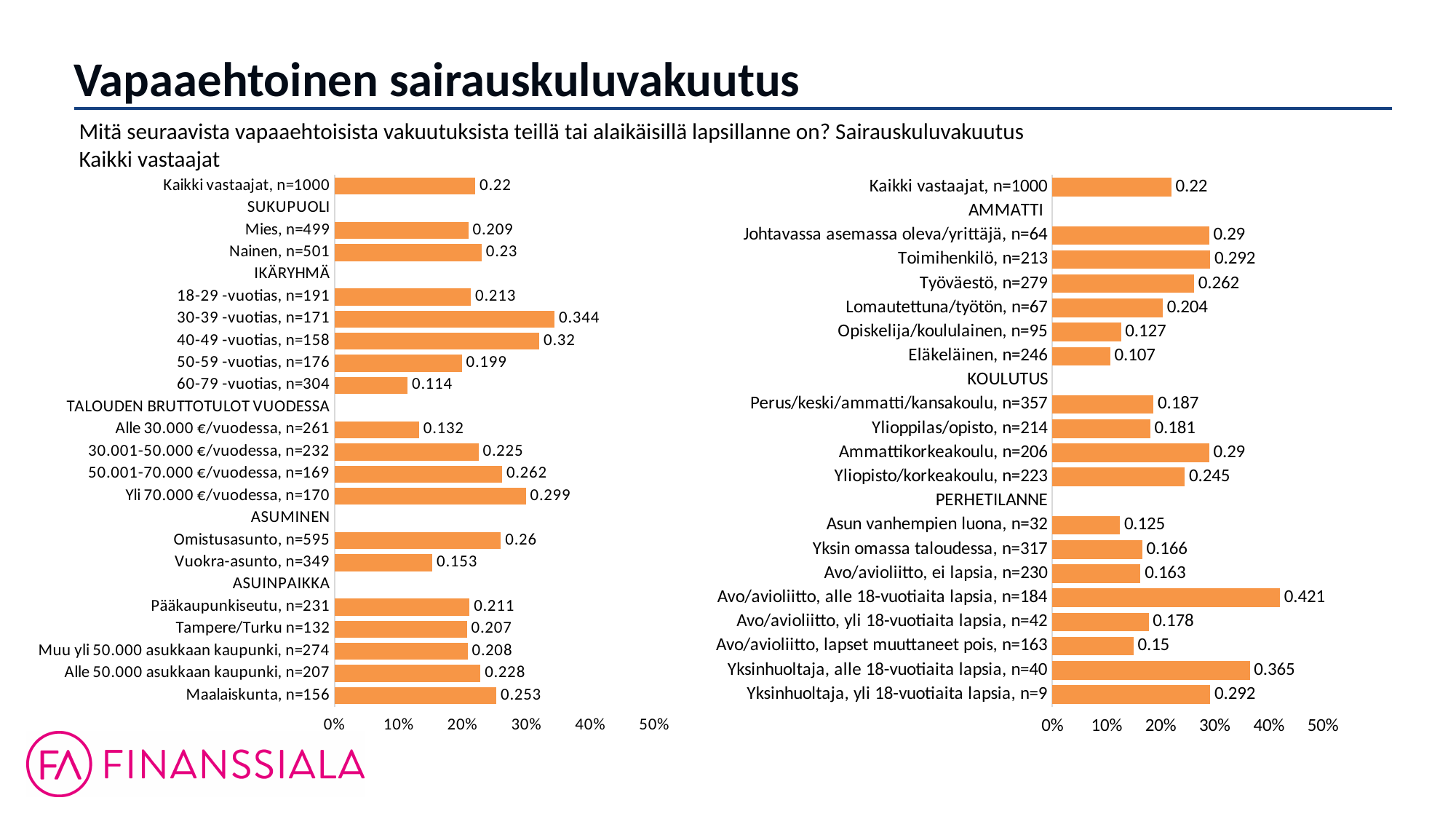
In the left chart, which is larger: the value for Omistusasunto, n=595 or Maalaiskunta, n=156? Omistusasunto, n=595 In the right chart, what is the value for Yksinhuoltaja, alle 18-vuotiaita lapsia, n=40? 0.365 In the right chart, which category has the highest value? Avo/avioliitto, alle 18-vuotiaita lapsia, n=184 In the left chart, what is the value for Vuokra-asunto, n=349? 0.153 In the left chart, what is the difference between the values for Yli 70.000 €/vuodessa, n=170 and Alle 30.000 €/vuodessa, n=261? 0.167 In the right chart, what is the difference between the values for Ammattikorkeakoulu, n=206 and Yliopisto/korkeakoulu, n=223? 0.045 In the right chart, is the value for Avo/avioliitto, alle 18-vuotiaita lapsia, n=184 greater or less than 40%? greater In the left chart, which category has the lowest value? 60-79 -vuotias, n=304 In the right chart, what is the value for Eläkeläinen, n=246? 0.107 In the left chart, which category has the highest value? 30-39 -vuotias, n=171 In the left chart, what is the value for 30-39 -vuotias, n=171? 0.344 What kind of chart is the left chart? Bar chart